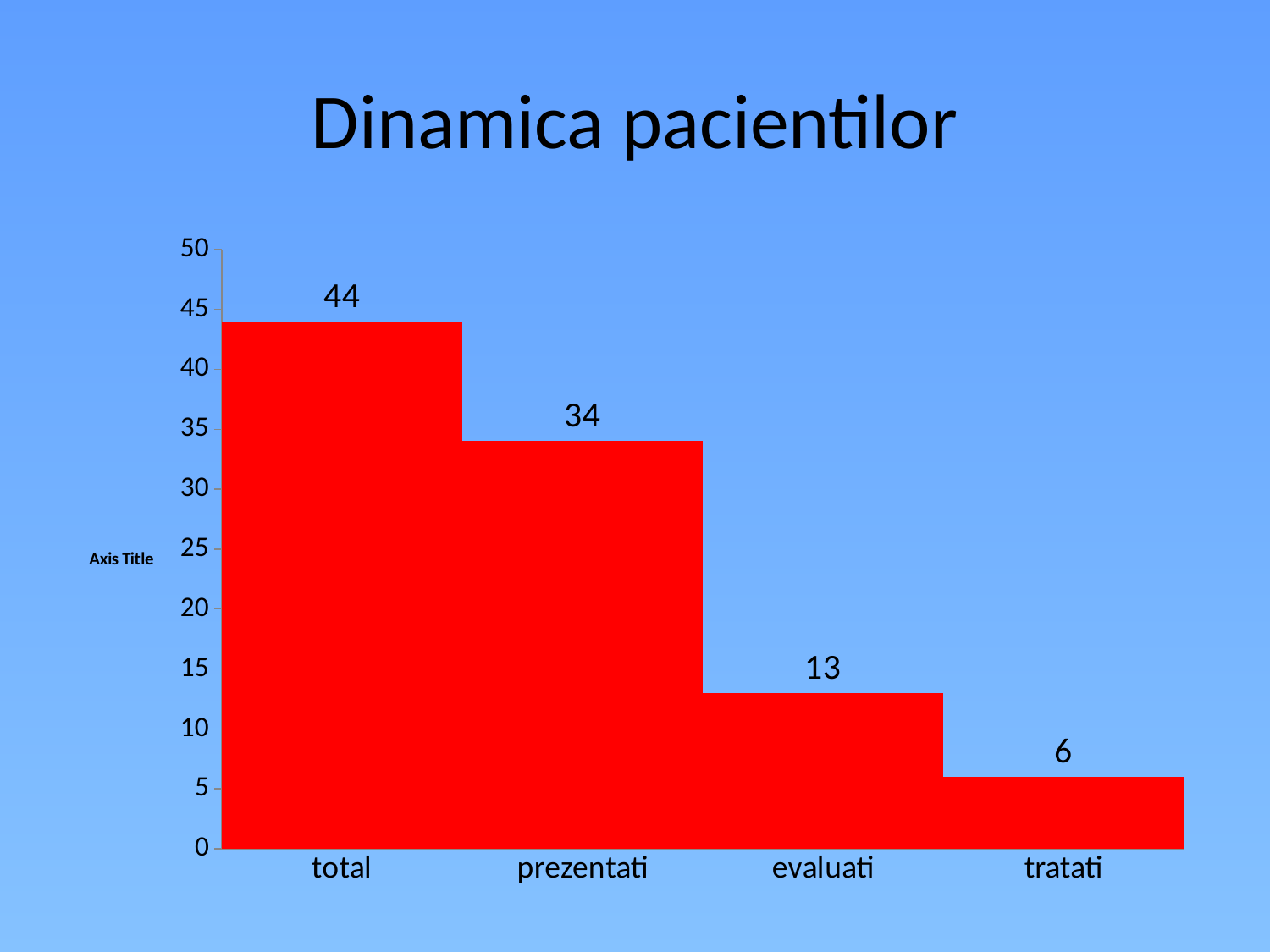
What kind of chart is shown on the slide? bar chart What is the difference between the values for total and prezentati? 10 Do the values rise or fall from left to right along the x axis? fall What is the difference between the values for evaluati and tratati? 7 Which is larger, the value for prezentati or the value for evaluati? prezentati What is the value for total? 44 Which category has the lowest value? tratati What is the value for evaluati? 13 How many categories are shown on the x axis? 4 What is the value for tratati? 6 Which category has the highest value? total What is the value for prezentati? 34